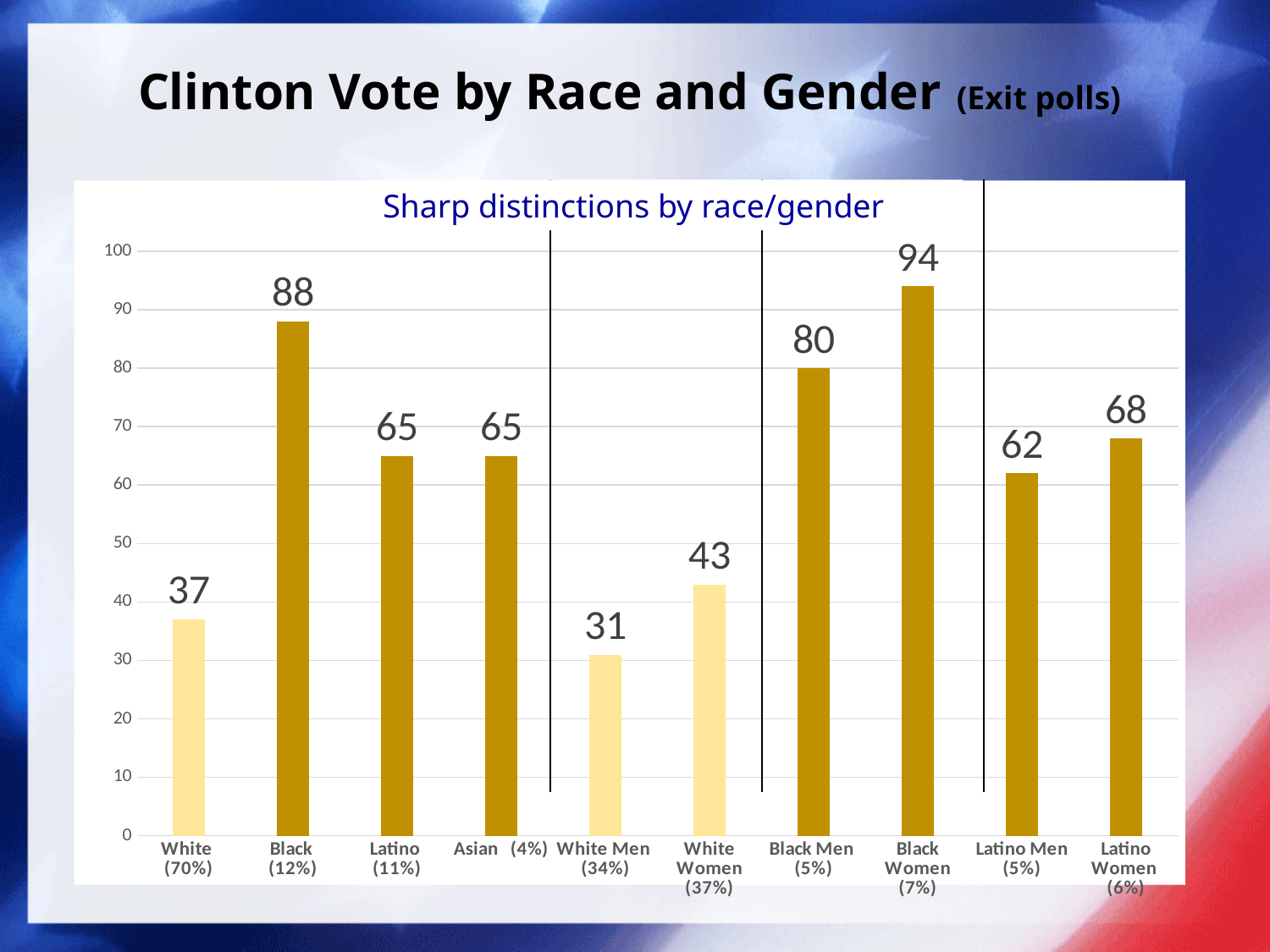
Is the value for Asian (4%) greater or less than 60? greater What is the difference between the values for Black (12%) and White (70%)? 51 How many categories are shown on the x axis? 10 What is the value for Latino Men (5%)? 62 What is the value for Black Women (7%)? 94 What is the value for White Men (34%)? 31 Which category has the highest value? Black Women (7%) Which is larger, the value for Black Men (5%) or the value for Latino Women (6%)? Black Men (5%) Which category has the lowest value? White Men (34%) What kind of chart is shown on the slide? bar chart What is the difference between the values for White Women (37%) and White Men (34%)? 12 What is the chart's title? Sharp distinctions by race/gender